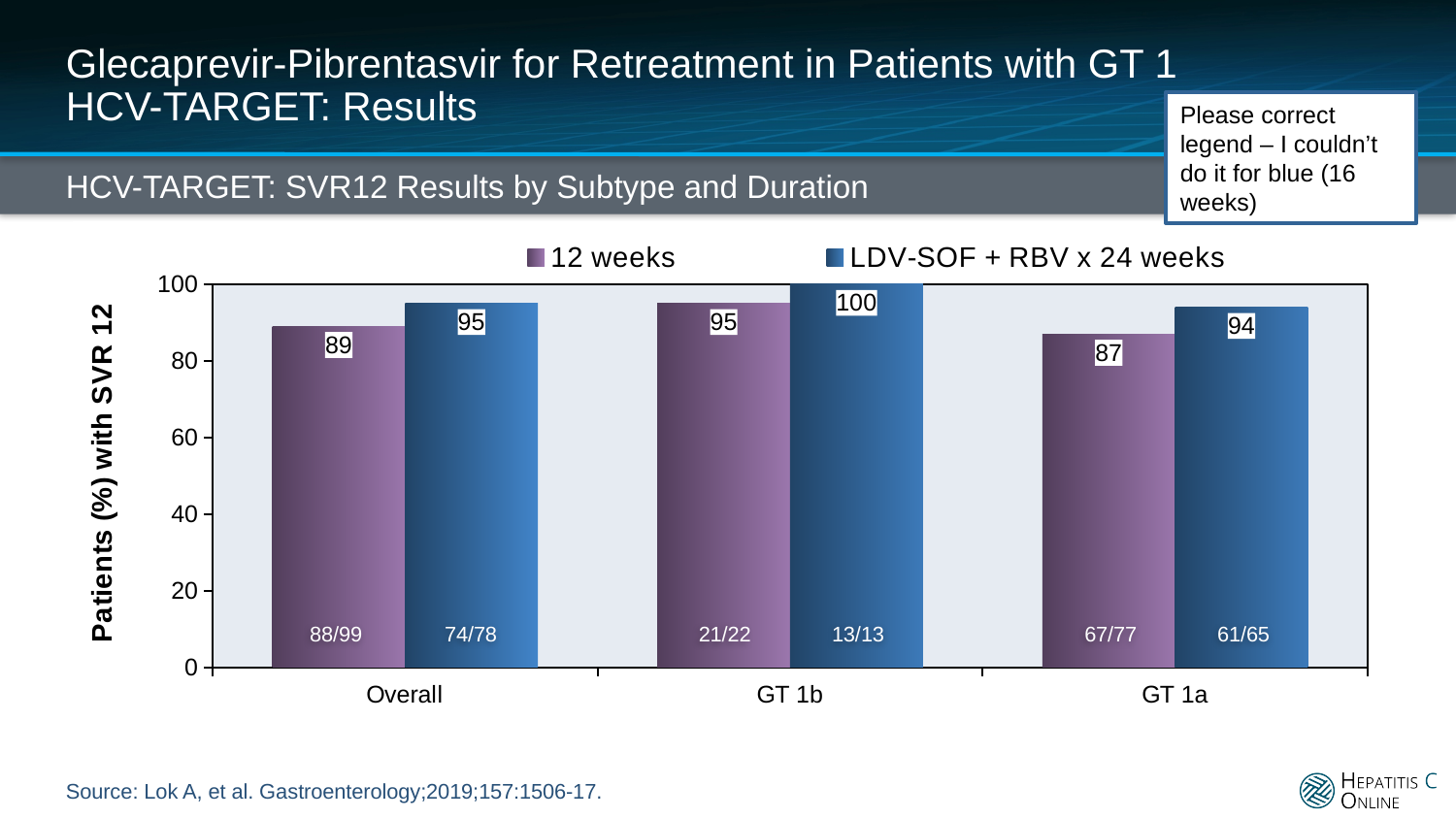
Which category has the highest value for the 12 weeks series? GT 1b What is the SVR12 value for the 12 weeks series in the GT 1a category? 87 What is the SVR12 value for the LDV-SOF + RBV x 24 weeks series in the GT 1b category? 100 Which category has the lowest value for the LDV-SOF + RBV x 24 weeks series? GT 1a How many categories are shown on the x axis? 3 What is the difference between the LDV-SOF + RBV x 24 weeks value and the 12 weeks value in the GT 1a category? 7 What is the label of the y axis? Patients (%) with SVR 12 What is the SVR12 value for the 12 weeks series in the Overall category? 89 How many series does the legend list? 2 What fraction of patients is shown inside the LDV-SOF + RBV x 24 weeks bar for GT 1a? 61/65 In the Overall category, which series has the larger value: 12 weeks or LDV-SOF + RBV x 24 weeks? LDV-SOF + RBV x 24 weeks What kind of chart is shown on the slide? Bar chart